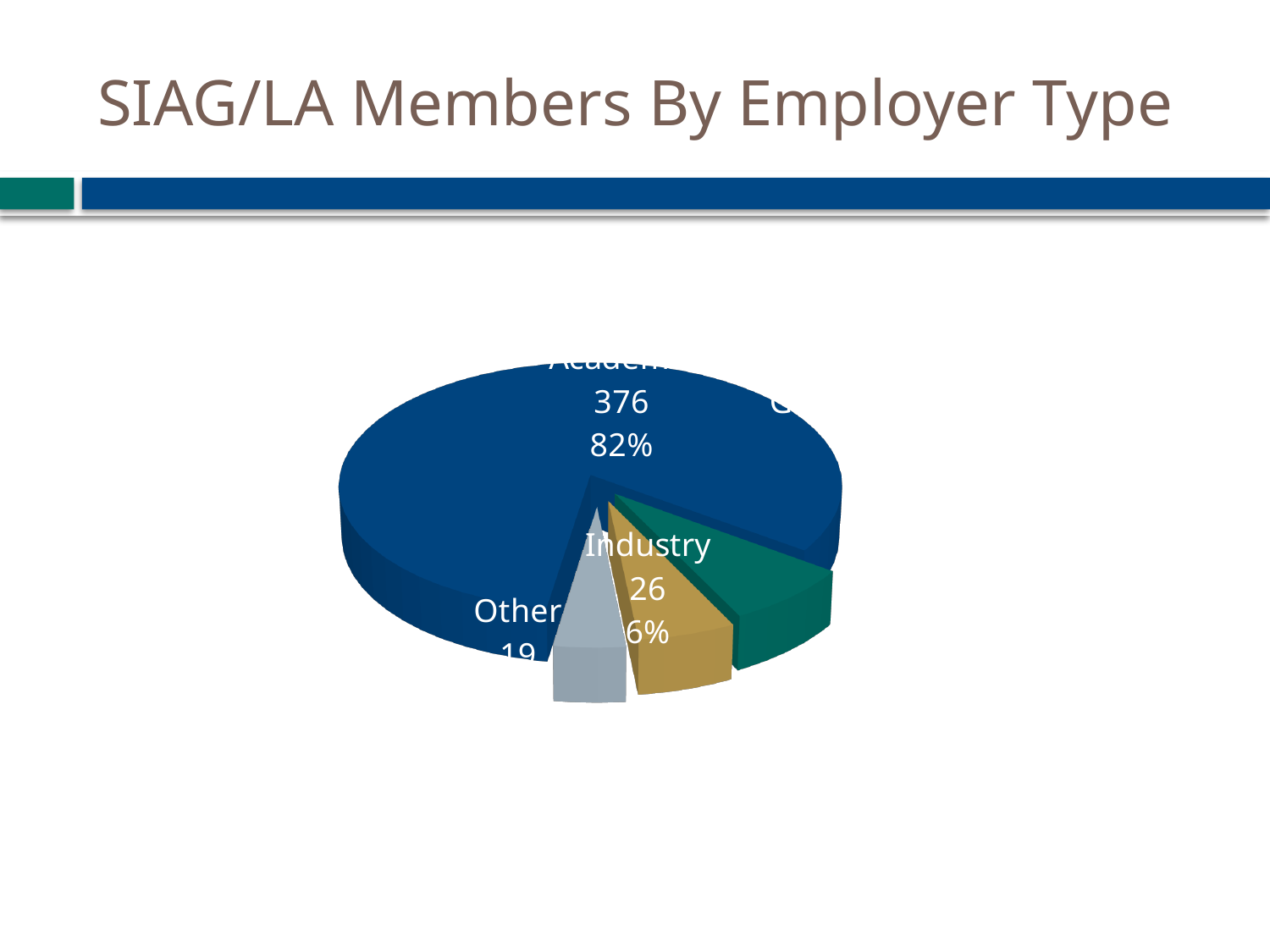
What colour is the Industry slice? gold How many members are in the Industry slice? 26 How many members are in the Other slice? 19 What kind of chart is shown on the slide? pie chart What is the difference between the Industry value and the Other value? 7 How many slices does the pie chart have? 4 What percentage of the pie does the Industry slice represent? 6% Which slice is larger, Industry or Other? Industry What is the value shown on the largest slice of the pie? 376 What percentage of the pie does the largest slice represent? 82% What is the title of the chart? SIAG/LA Members By Employer Type